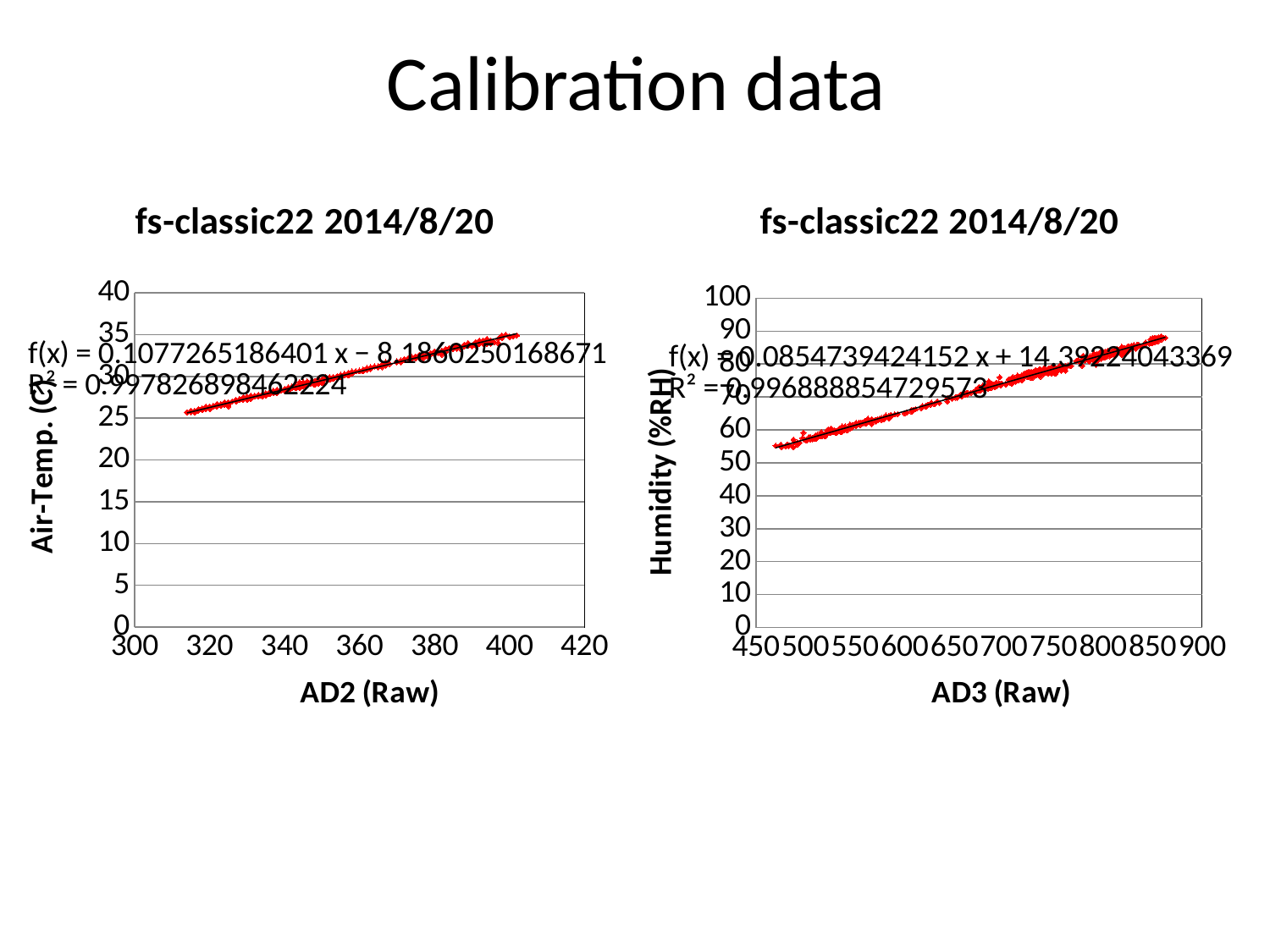
What is the x-axis title of the left chart? AD2 (Raw) In the right chart, is the Humidity value at AD3 (Raw) = 500 greater or less than 60? less In the right chart, what is the slope of the fitted line f(x) shown on the chart? 0.0854739424152 In the right chart, do the Humidity values rise or fall as AD3 (Raw) increases? rise What kind of chart is the right chart on the slide? scatter chart In the right chart, is the Humidity value at AD3 (Raw) = 850 greater or less than 80? greater What is the y-axis title of the right chart? Humidity (%RH) In the left chart, what is the slope of the fitted line f(x) shown on the chart? 0.1077265186401 What kind of chart is the left chart on the slide? scatter chart In the left chart, do the Air-Temp values rise or fall as AD2 (Raw) increases? rise In the left chart, is the Air-Temp value at AD2 (Raw) = 320 greater or less than 30? less